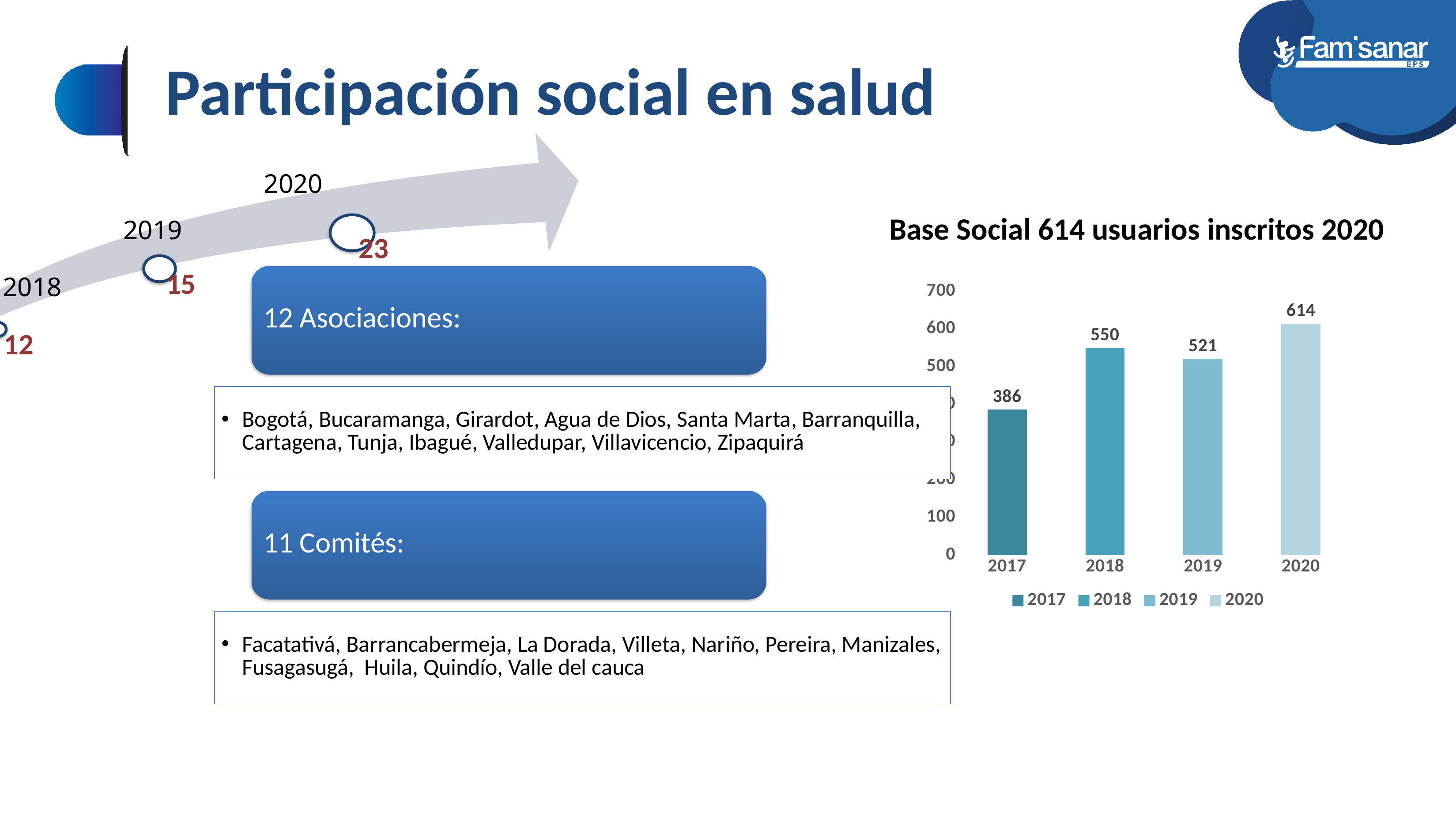
How many entries does the legend of the bar chart list? 4 What is the difference between the values for 2020 and 2017 in the bar chart? 228 What is the value for 2019 in the bar chart? 521 How many years are shown on the x axis of the bar chart? 4 What is the value for 2017 in the bar chart? 386 What kind of chart is shown on the slide? Bar chart Which year has the lowest value in the bar chart? 2017 Which is larger in the bar chart, the value for 2018 or the value for 2019? 2018 What is the value for 2020 in the bar chart? 614 Which year has the highest value in the bar chart? 2020 What is the difference between the values for 2018 and 2019 in the bar chart? 29 What is the value for 2018 in the bar chart? 550